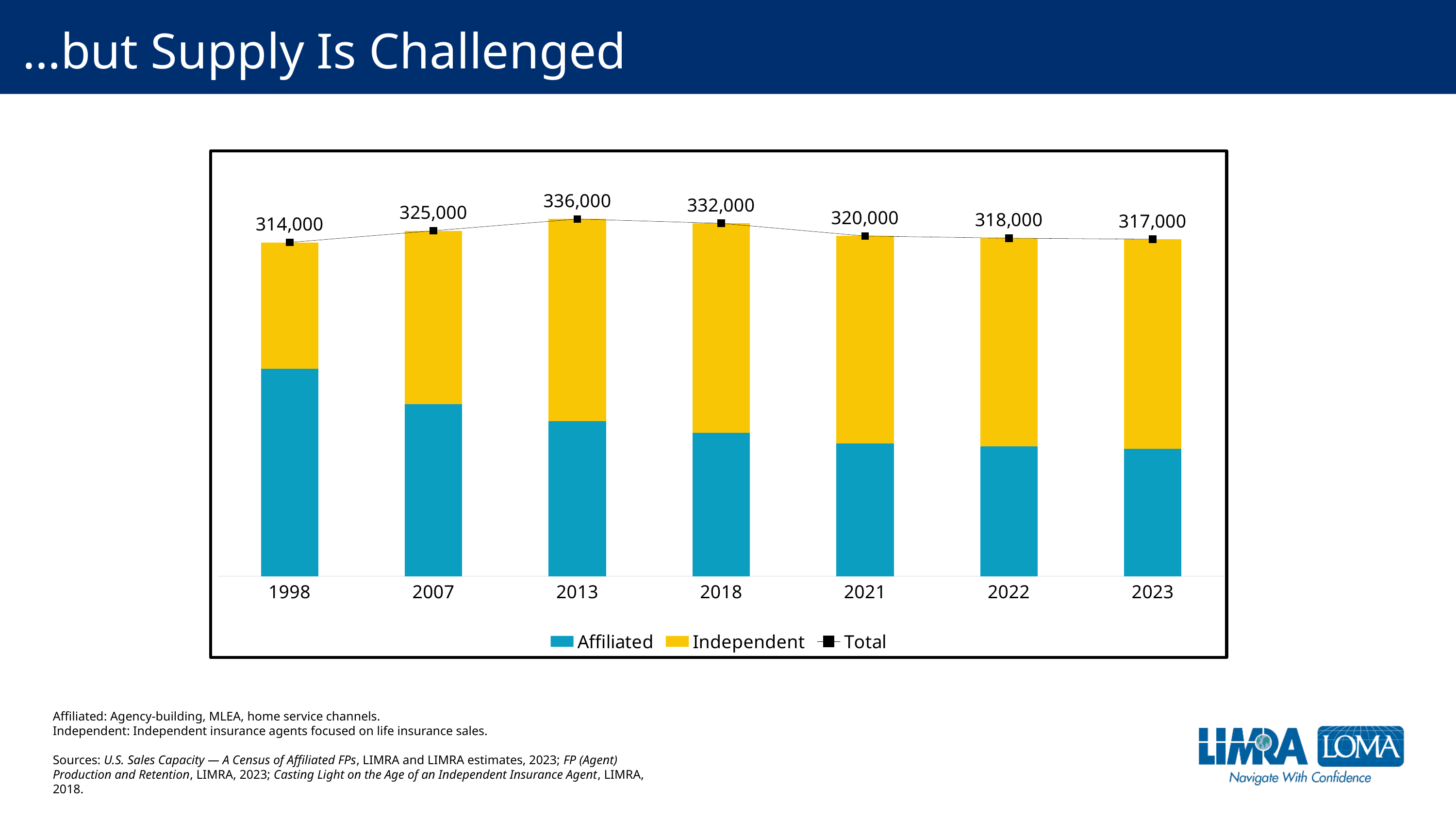
How many years are shown on the x axis? 7 What is the Total value for 2013? 336,000 Which year has the highest Total? 2013 Which year has the lowest Total? 1998 What is the Total value for 1998? 314,000 What is the Total value for 2023? 317,000 Does the Total rise or fall from 2013 to 2023? Fall Which is larger in 2023, the Affiliated segment or the Independent segment? Independent What is the difference between the Total for 2018 and the Total for 2021? 12,000 What is the difference between the Total for 2013 and the Total for 1998? 22,000 What kind of chart is shown on the slide? Stacked bar chart with a line How many series does the legend list? 3